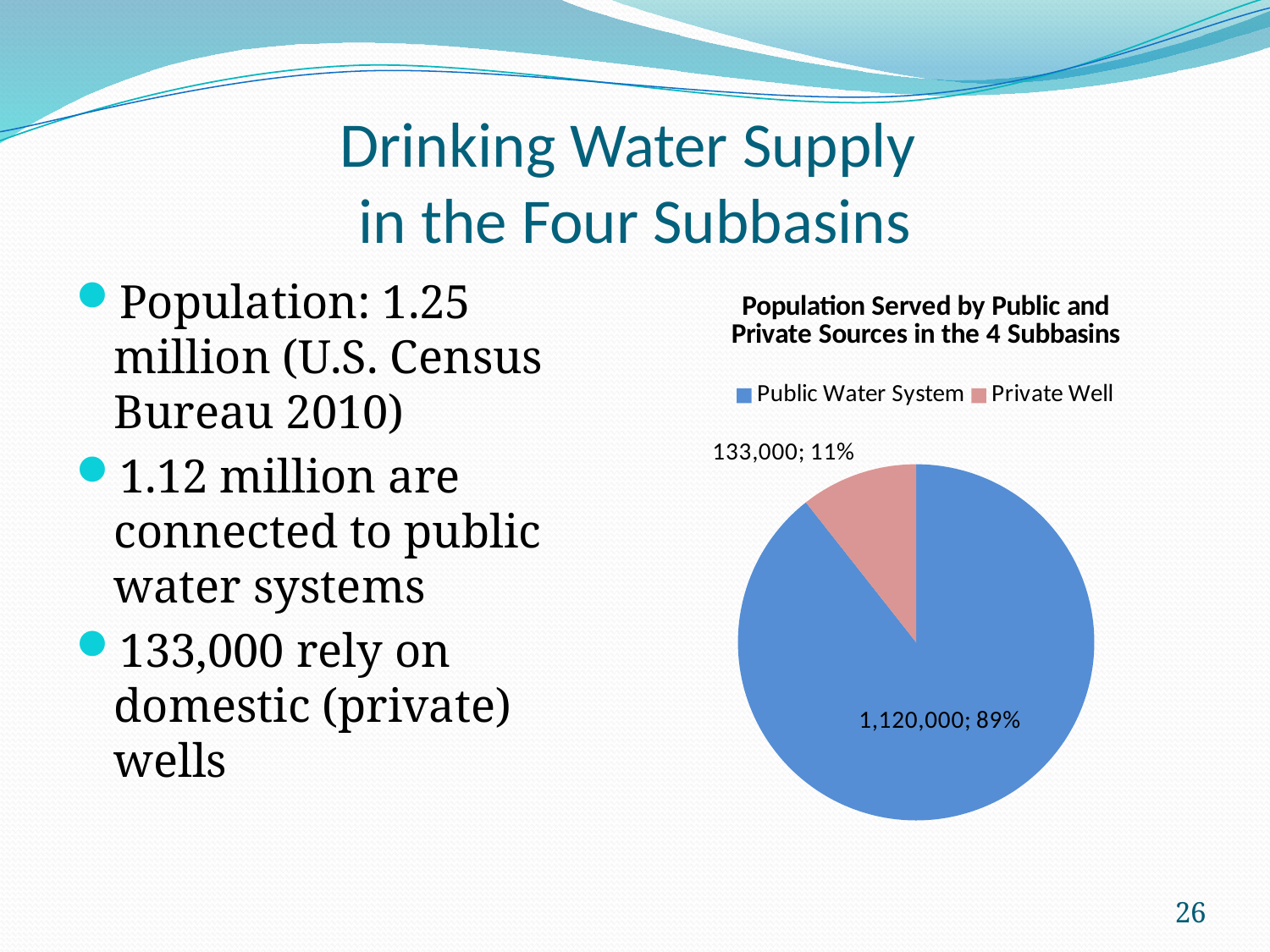
Which category has the largest slice of the pie? Public Water System What is the population served by Private Well according to the chart? 133,000 What is the population served by the Public Water System according to the chart? 1,120,000 How many entries does the chart legend list? 2 What is the title of the chart? Population Served by Public and Private Sources in the 4 Subbasins Which category has the smallest slice of the pie? Private Well What is the difference between the population served by the Public Water System and by Private Well? 987,000 What share of the pie does the Private Well slice represent? 11% How many slices does the pie chart have? 2 What kind of chart is shown on the slide? pie chart Which colour represents Private Well in the pie chart? pink What share of the pie does the Public Water System slice represent? 89%